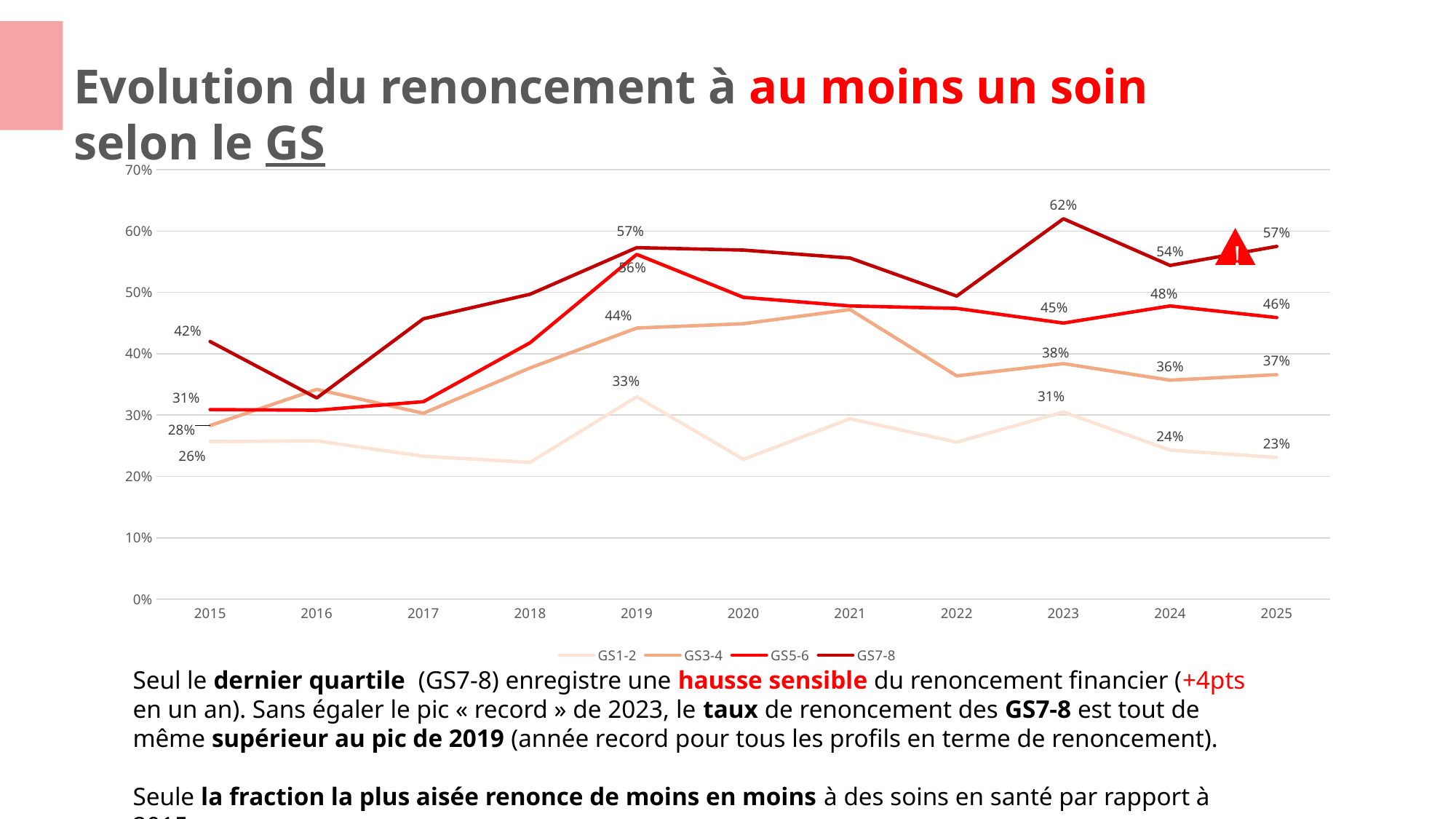
How many series does the legend list? 4 Is the value for GS1-2 in 2020 greater or less than 30%? less What is the value for GS5-6 in 2015? 31% What is the value for GS3-4 in 2019? 44% What kind of chart is shown on the slide? Line chart Which series has the highest value in 2025? GS7-8 What is the value for GS7-8 in 2023? 62% Is the value for GS5-6 larger in 2024 or in 2025? 2024 What is the difference between GS7-8 and GS1-2 in 2023? 31 percentage points What is the value for GS1-2 in 2025? 23% Which series has the lowest value in 2019? GS1-2 How many years are shown on the x axis? 11